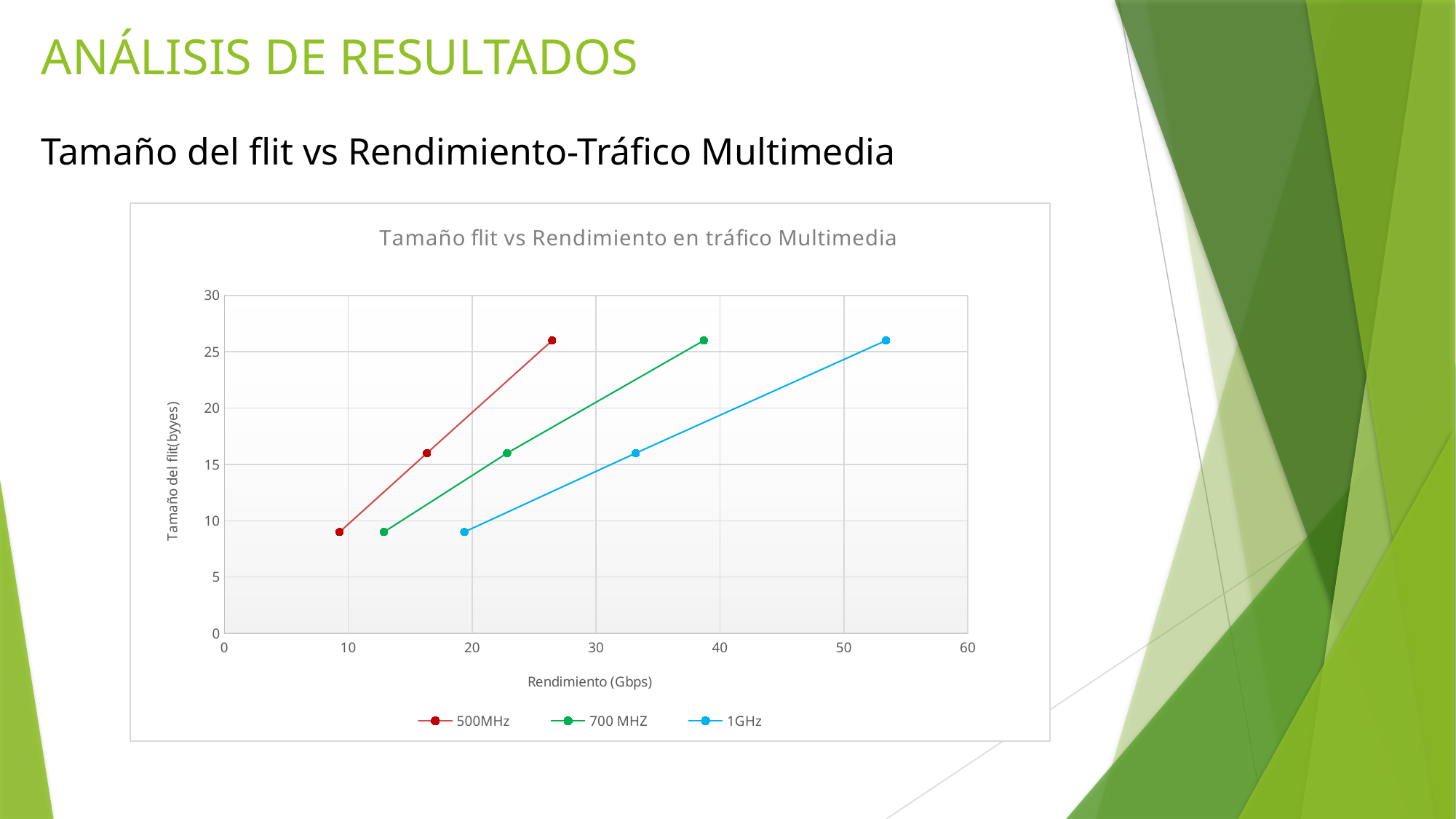
For each series, does the flit size rise or fall as Rendimiento increases along the x axis? rise Which series has the lowest Rendimiento (Gbps) values overall? 500MHz Is the Rendimiento value of the highest point of the 1GHz series greater or less than 50? greater What is the label of the x axis? Rendimiento (Gbps) Is the Rendimiento value of the highest point of the 500MHz series greater or less than 30? less What kind of chart is shown on the slide? line chart Is the Rendimiento value of the highest point of the 700 MHZ series greater or less than 30? greater How many series does the legend list? 3 What is the title of the chart? Tamaño flit vs Rendimiento en tráfico Multimedia How many data points are plotted for the 500MHz series? 3 Which series reaches the highest Rendimiento (Gbps) value? 1GHz